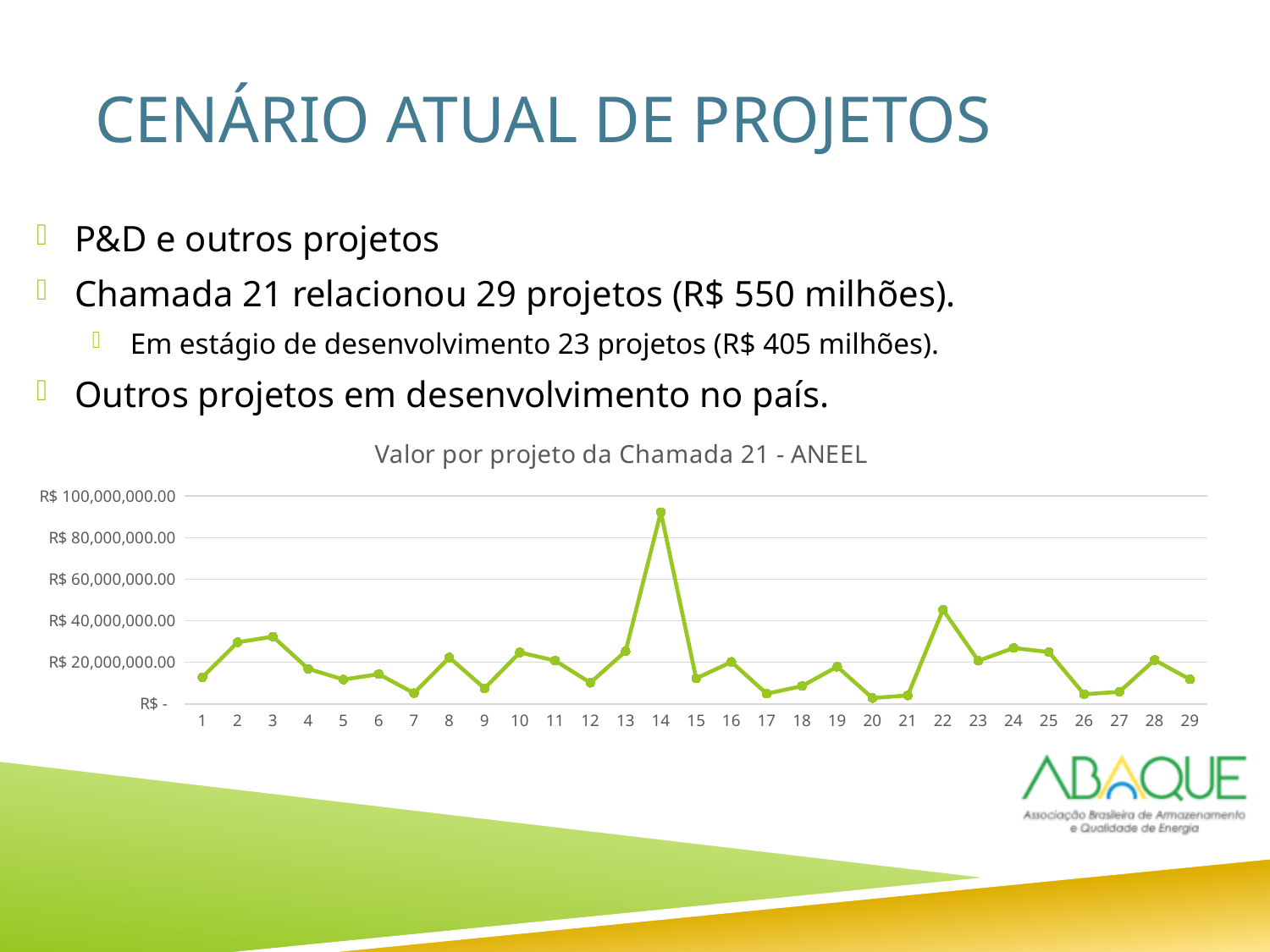
Is the value for project 20 greater or less than R$ 20,000,000.00? less What is the title of the chart? Valor por projeto da Chamada 21 - ANEEL How many projects are plotted along the x axis of the chart? 29 Is the value for project 22 greater or less than R$ 40,000,000.00? greater Is the value for project 14 greater or less than R$ 80,000,000.00? greater What kind of chart is shown on the slide? line chart What is the highest value shown on the y axis of the chart? R$ 100,000,000.00 Which project has the highest value in the chart? 14 Which has a larger value, project 2 or project 7? project 2 Which has a larger value, project 14 or project 22? project 14 Does the value rise or fall from project 14 to project 15? fall